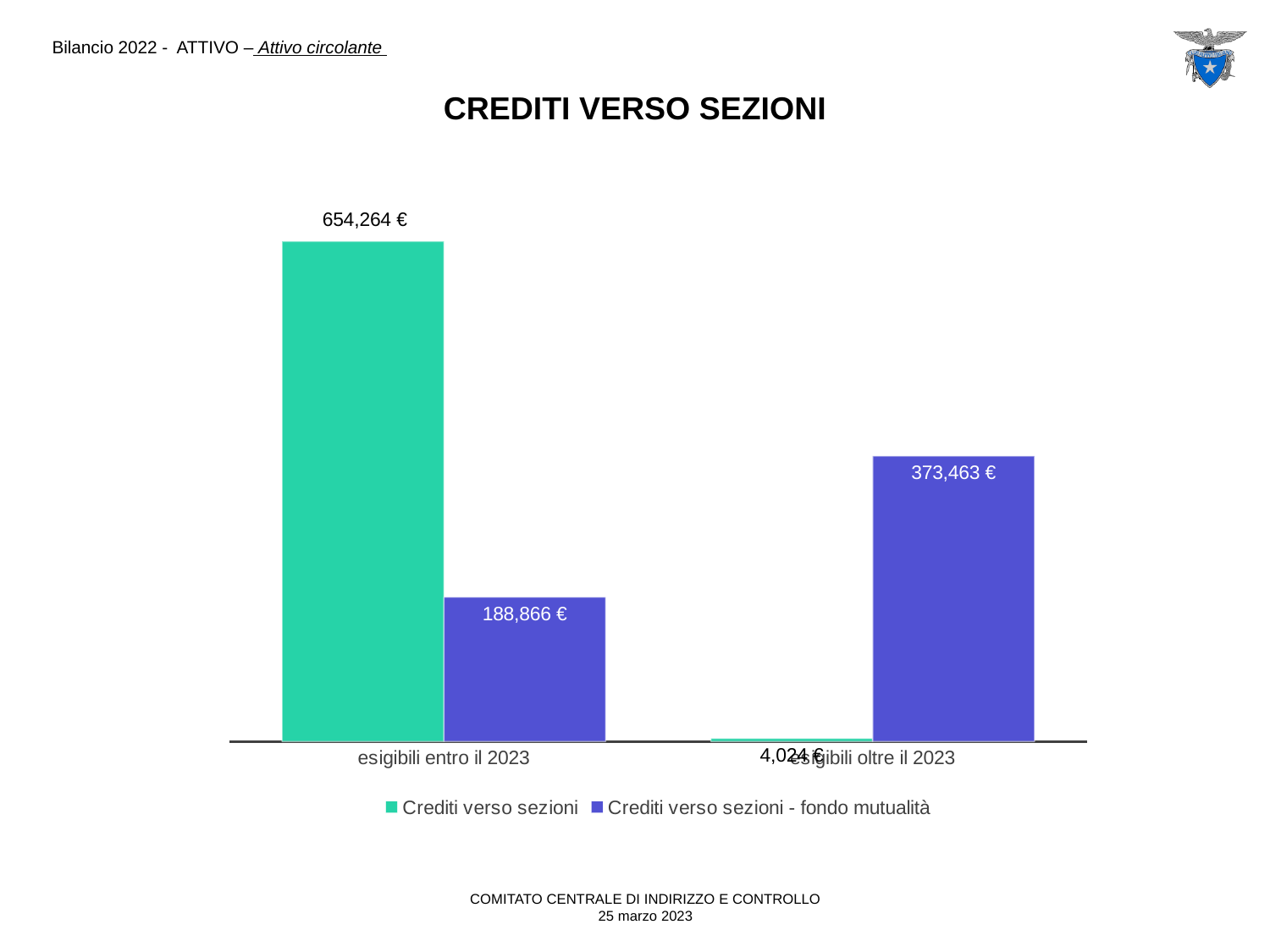
What is the value of Crediti verso sezioni for esigibili entro il 2023? 654,264 € Which is larger for esigibili oltre il 2023: Crediti verso sezioni or Crediti verso sezioni - fondo mutualità? Crediti verso sezioni - fondo mutualità What type of chart is shown on the slide? Bar chart How many categories are shown on the x axis? 2 What is the difference between the Crediti verso sezioni - fondo mutualità values for esigibili oltre il 2023 and esigibili entro il 2023? 184,597 € What is the difference between Crediti verso sezioni and Crediti verso sezioni - fondo mutualità for esigibili entro il 2023? 465,398 € Which bar has the highest value in the chart? Crediti verso sezioni, esigibili entro il 2023 Which bar has the lowest value in the chart? Crediti verso sezioni, esigibili oltre il 2023 What is the value of Crediti verso sezioni - fondo mutualità for esigibili oltre il 2023? 373,463 € What is the value of Crediti verso sezioni for esigibili oltre il 2023? 4,024 € What is the value of Crediti verso sezioni - fondo mutualità for esigibili entro il 2023? 188,866 € How many series does the legend list? 2